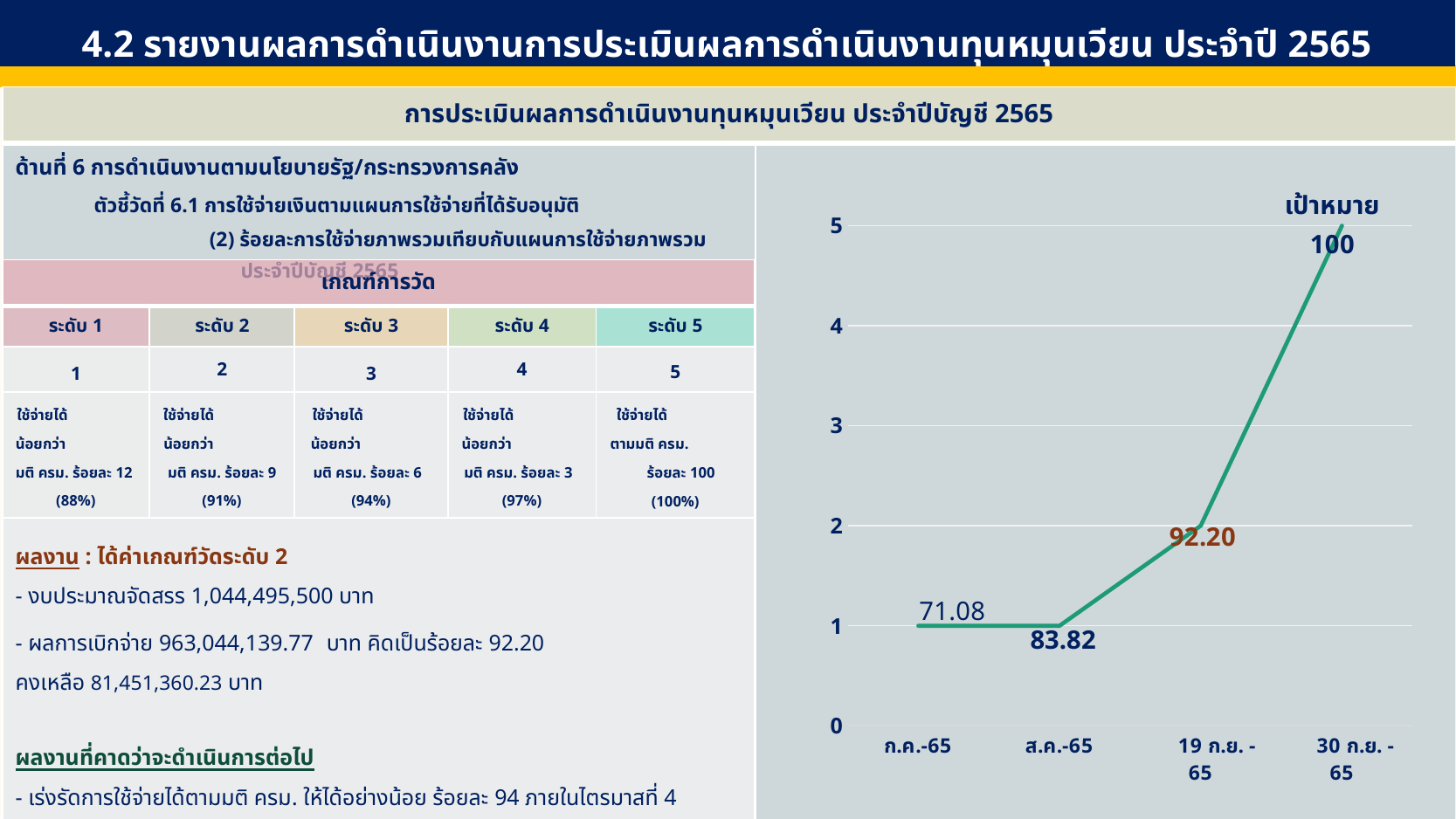
Do the values on the line chart rise or fall from ก.ค.-65 to 30 ก.ย.-65? rise What data label is shown for 30 ก.ย.-65 on the line chart? 100 What data label is shown for ก.ค.-65 on the line chart? 71.08 Which has the larger labelled value on the line chart, ส.ค.-65 or 19 ก.ย.-65? 19 ก.ย.-65 What kind of chart is shown on the right side of the slide? line chart What data label is shown for 19 ก.ย.-65 on the line chart? 92.20 How many data points are plotted on the line chart? 4 What is the difference between the labelled values for 30 ก.ย.-65 and 19 ก.ย.-65 on the line chart? 7.80 Which category on the line chart has the lowest labelled value? ก.ค.-65 Which category on the line chart has the highest labelled value? 30 ก.ย.-65 On the line chart, is the plotted level for 30 ก.ย.-65 greater or less than 4? greater What data label is shown for ส.ค.-65 on the line chart? 83.82